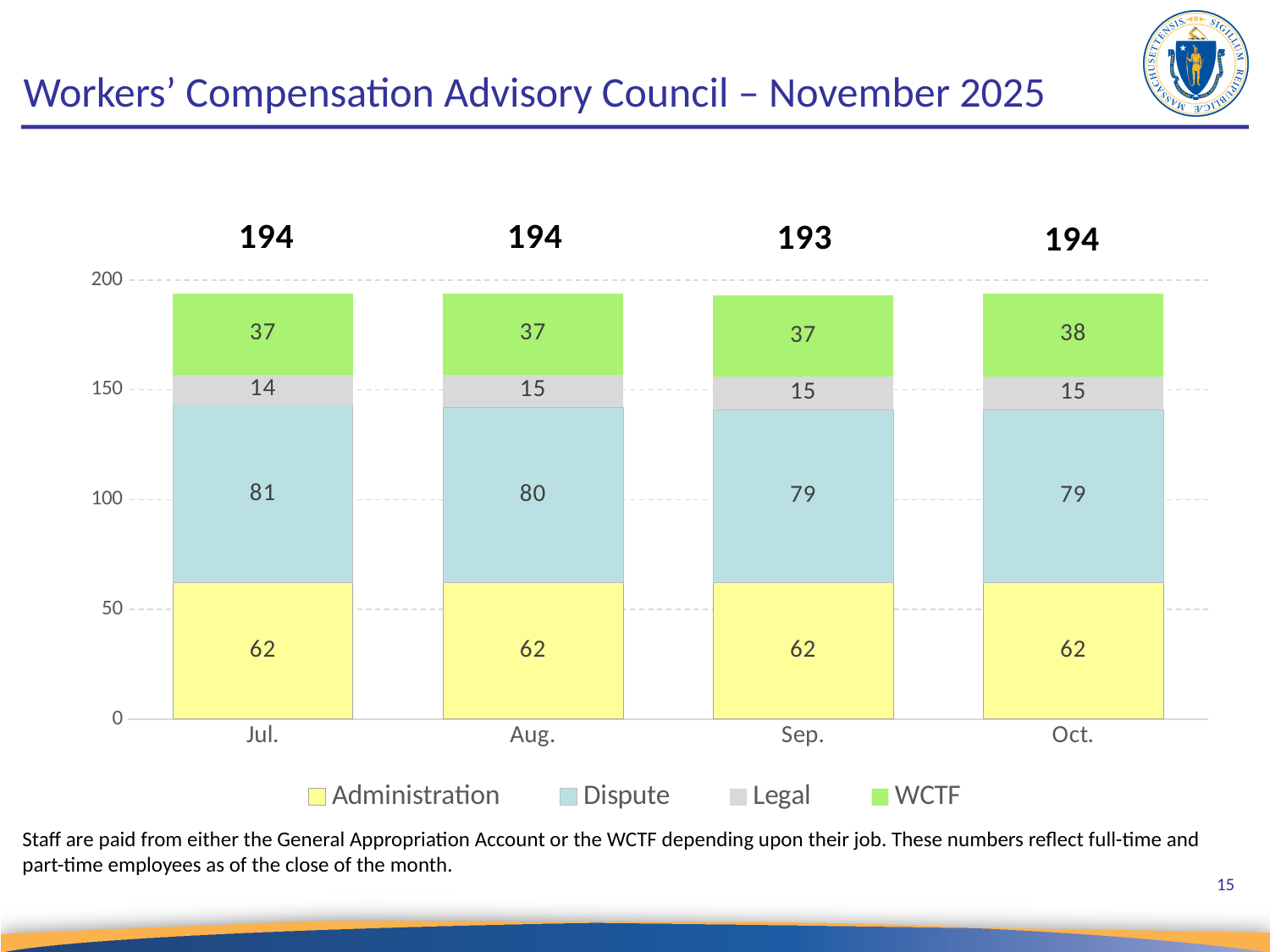
Which series is shown in green in the legend? WCTF What is the WCTF value for Oct.? 38 How many series does the legend list? 4 Does the Dispute value rise or fall from Jul. to Sep.? fall What is the difference between the Dispute values for Jul. and Oct.? 2 Is the Dispute value for Aug. larger or smaller than the Dispute value for Sep.? larger What kind of chart is shown? stacked bar chart Which month has the lowest total? Sep. How many months are shown on the x axis? 4 What is the Dispute value for Jul.? 81 What is the Legal value for Aug.? 15 What is the total of the stacked bar for Sep.? 193